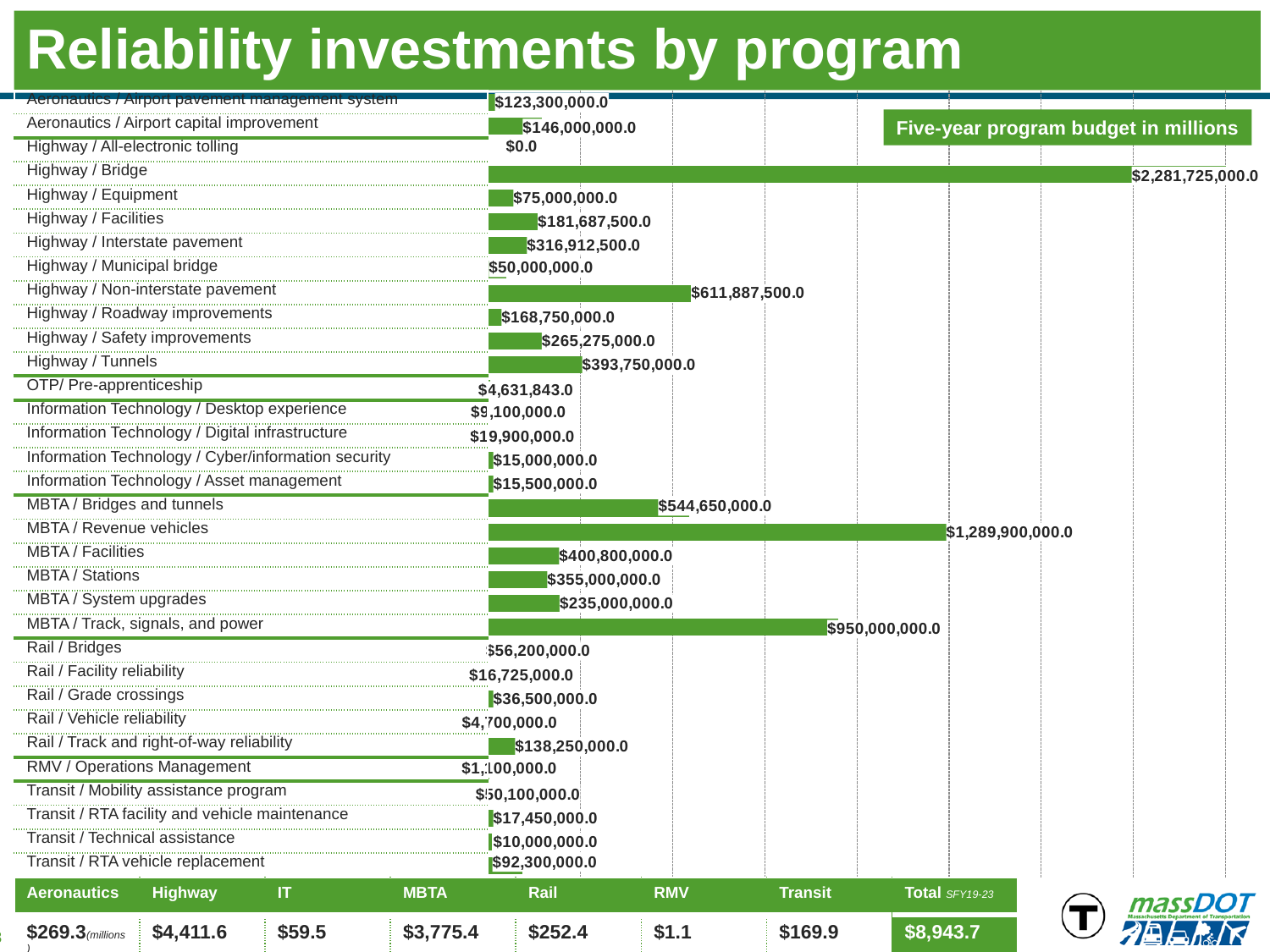
What is the value for Rail / Track and right-of-way reliability? $138,250,000.0 What is the difference between MBTA / Revenue vehicles and MBTA / Track, signals, and power? $339,900,000.0 What kind of chart is shown on the slide? Bar chart What is the value for MBTA / Revenue vehicles? $1,289,900,000.0 What is the value for Highway / Bridge? $2,281,725,000.0 Which is larger, MBTA / Facilities or MBTA / Stations? MBTA / Facilities Which program has the lowest value? Highway / All-electronic tolling What is the value for Highway / Tunnels? $393,750,000.0 Which program has the highest value? Highway / Bridge Which is larger, Highway / Non-interstate pavement or MBTA / Bridges and tunnels? Highway / Non-interstate pavement How many programs are plotted in the chart? 33 What is the title of the chart? Reliability investments by program